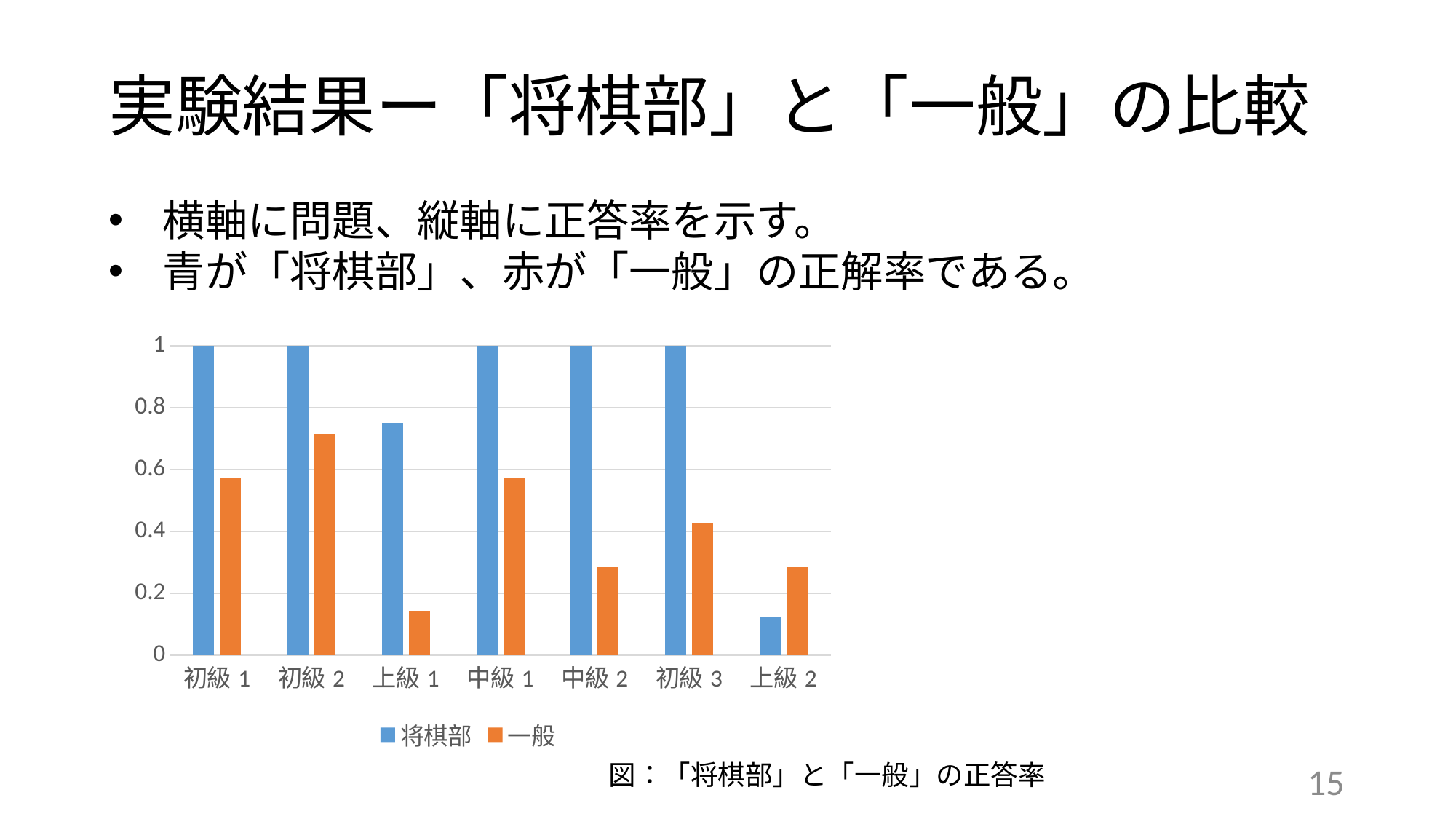
What is the value for 将棋部 at 初級 1? 1 Which category has the lowest value for 一般? 上級 1 Which category has the lowest value for 将棋部? 上級 2 What kind of chart is shown on the slide? bar chart What is the value for 将棋部 at 中級 2? 1 Is the value for 一般 at 初級 2 greater or less than 0.6? greater Is the value for 将棋部 at 上級 1 greater or less than 0.6? greater At 上級 1, which series has the larger value, 将棋部 or 一般? 将棋部 Is the value for 一般 at 上級 1 greater or less than 0.2? less How many categories are shown on the x axis of the chart? 7 Which category has the highest value for 一般? 初級 2 How many series does the chart's legend list? 2